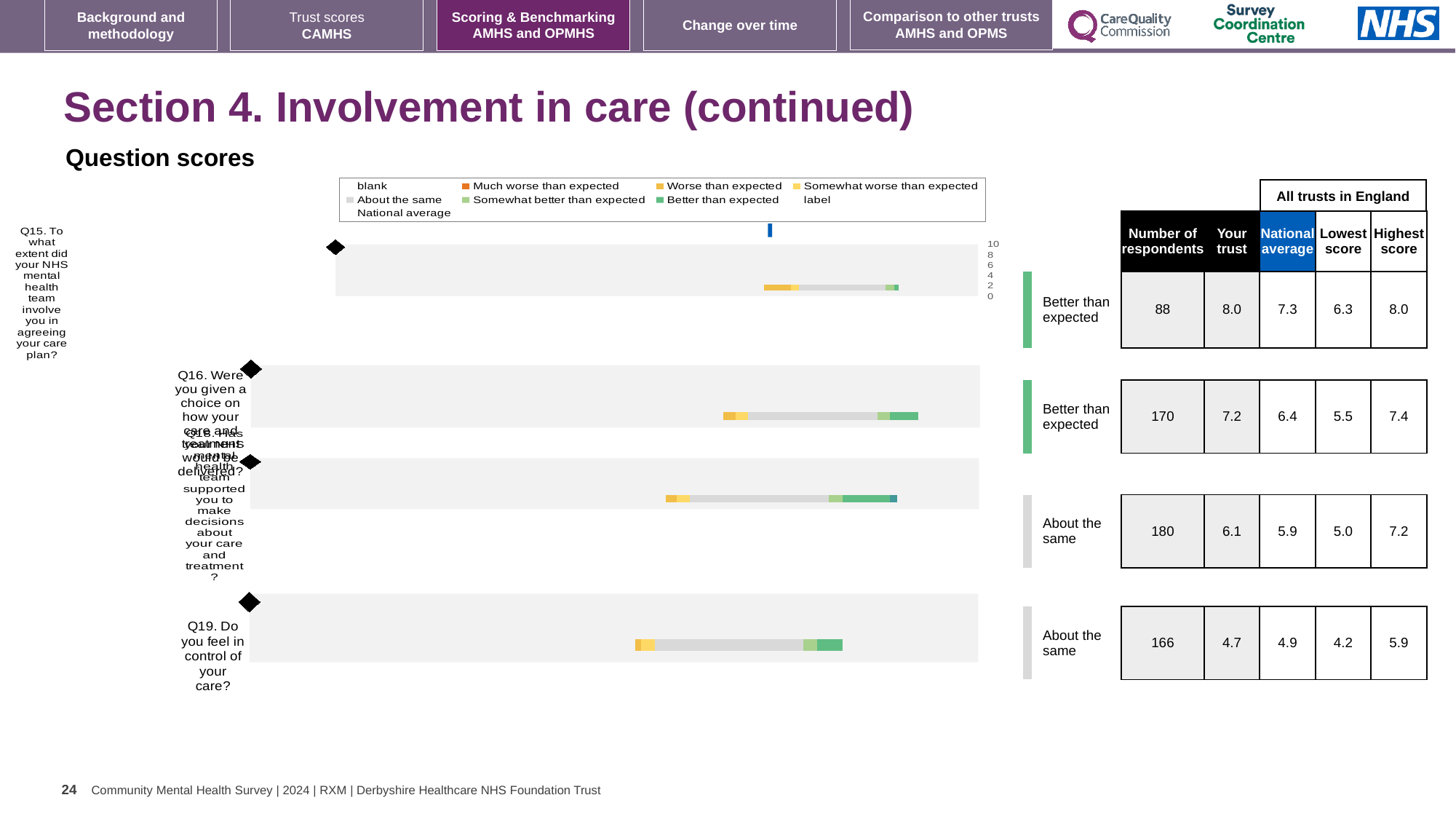
In the legend of the question scores chart, which category is shown in dark orange? Much worse than expected What type of chart is used to show the question scores on this slide? bar chart In the table beside the chart, what is the 'Your trust' score for Q15 (involving you in agreeing your care plan)? 8.0 For Q16, how much higher is the 'Your trust' score than the national average in the table beside the chart? 0.8 Which question has the highest 'Your trust' score in the table beside the chart? Q15 In the table beside the chart, what is the national average for Q19 (Do you feel in control of your care?)? 4.9 In the table beside the chart, how many respondents answered Q18 (supported to make decisions about your care and treatment)? 180 How many survey questions are plotted as bars in the question scores chart? 4 What benchmark label is shown next to the Q19 bar in the question scores chart? About the same For Q18, which is larger in the table beside the chart: the 'Your trust' score or the national average? Your trust How many entries does the legend of the question scores chart list? 9 Which question has the lowest 'Your trust' score in the table beside the chart? Q19